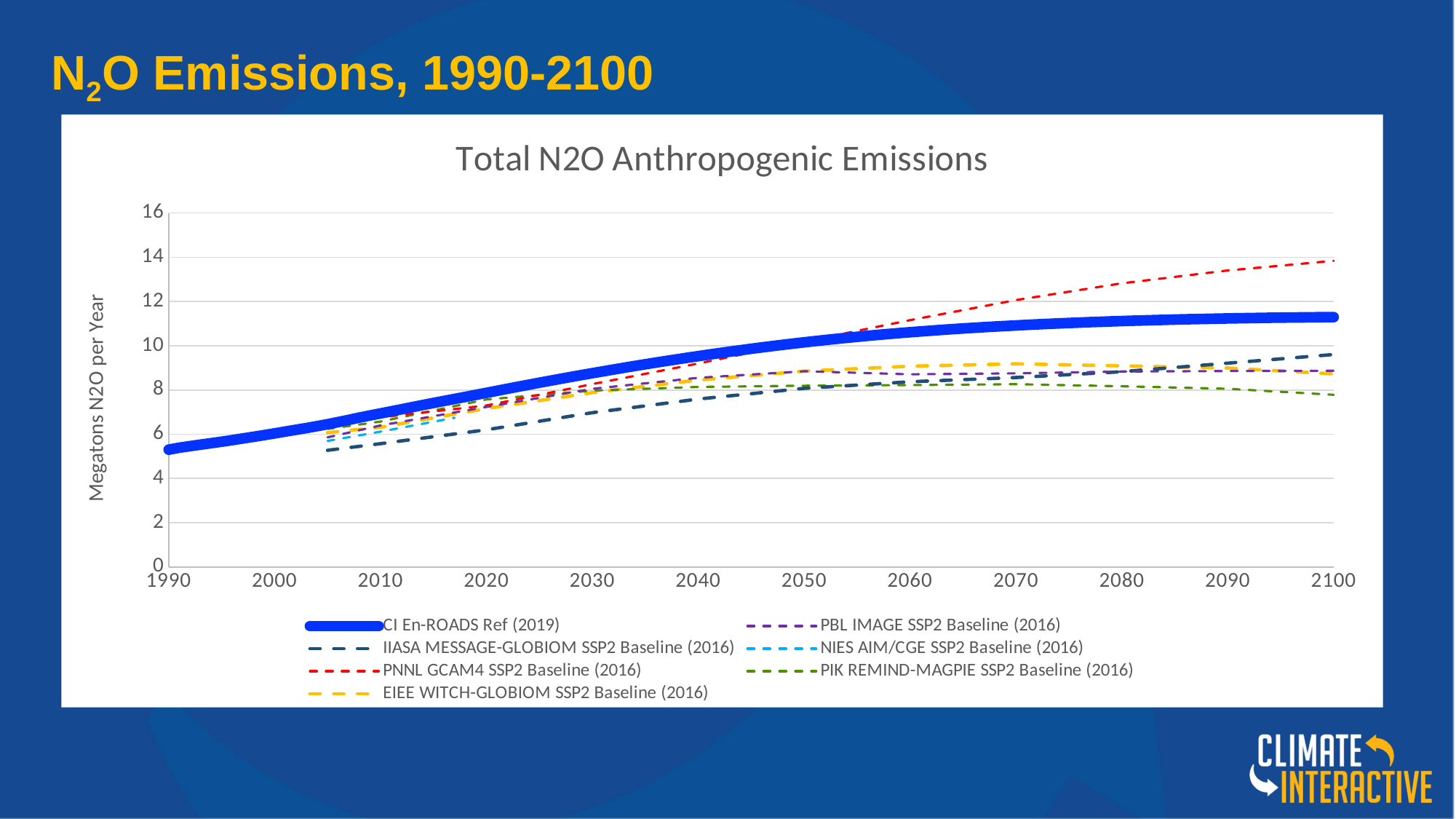
How many year labels are shown on the horizontal axis? 12 Which series has the highest value in 2100? PNNL GCAM4 SSP2 Baseline (2016) Is the value for PNNL GCAM4 SSP2 Baseline (2016) in 2100 greater or less than 12? greater What is the title of the chart? Total N2O Anthropogenic Emissions Is the value for PIK REMIND-MAGPIE SSP2 Baseline (2016) in 2100 greater or less than 10? less Does the CI En-ROADS Ref (2019) series rise or fall from 1990 to 2100? rise What kind of chart is shown on the slide? line chart Is the value for CI En-ROADS Ref (2019) in 1990 greater or less than 6? less What is the label on the vertical axis? Megatons N2O per Year In 2100, which is larger: CI En-ROADS Ref (2019) or IIASA MESSAGE-GLOBIOM SSP2 Baseline (2016)? CI En-ROADS Ref (2019) Which series has the lowest value in 2100? PIK REMIND-MAGPIE SSP2 Baseline (2016) How many series does the legend list? 7